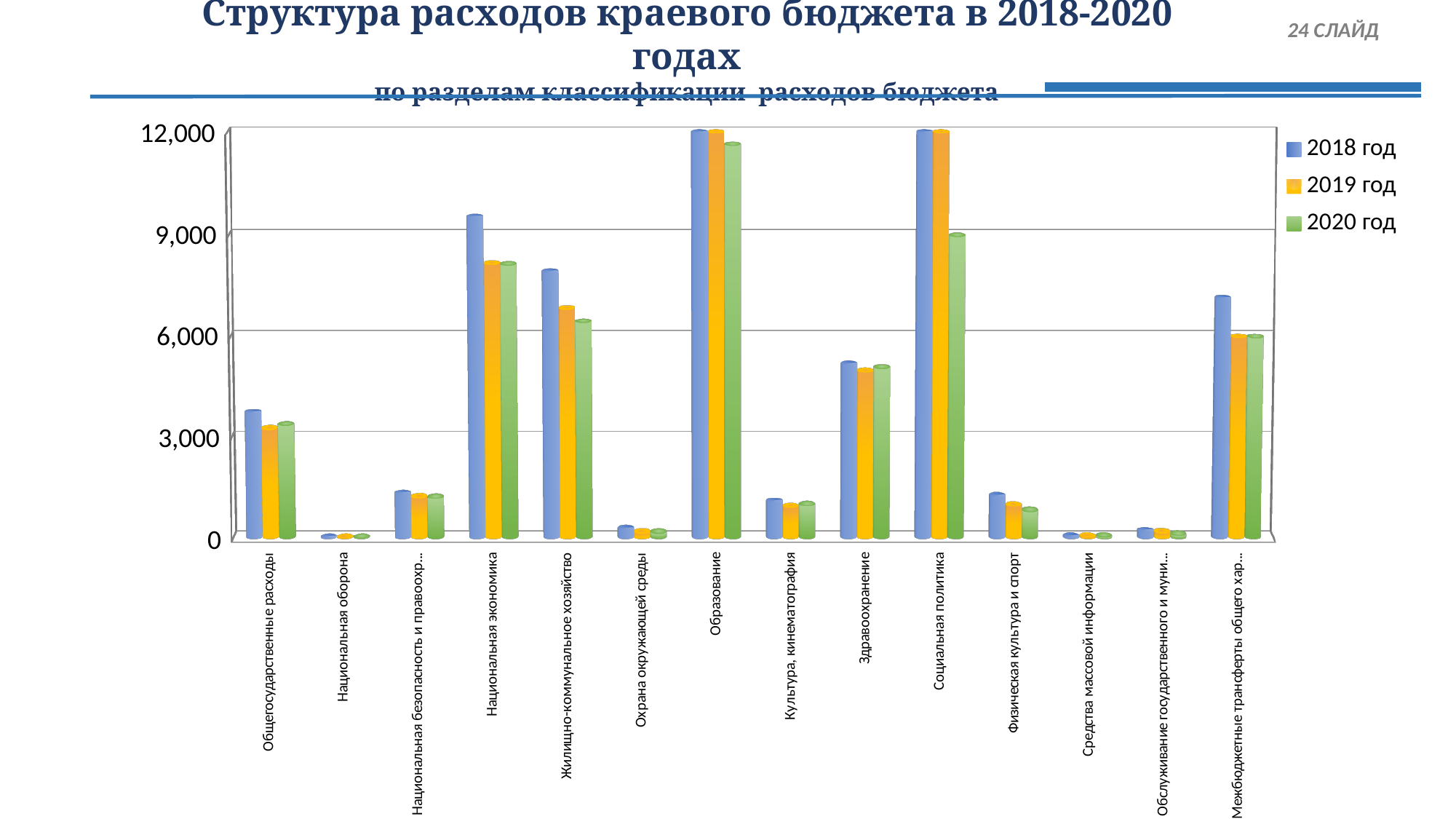
For Национальная экономика, which is larger: the 2018 год value or the 2019 год value? 2018 год Which series is shown in yellow in the legend? 2019 год Is the 2018 год value for Жилищно-коммунальное хозяйство greater or less than 6,000? greater What kind of chart is shown on the slide? Bar chart Is the 2018 год value for Национальная экономика greater or less than 9,000? greater Which category has the highest 2020 год value? Образование For 2020 год, which is larger: Образование or Социальная политика? Образование How many series does the legend list? 3 How many categories are shown along the x axis? 14 Does the value for Социальная политика rise or fall from 2018 год to 2020 год? fall Is the 2018 год value for Здравоохранение greater or less than 6,000? less